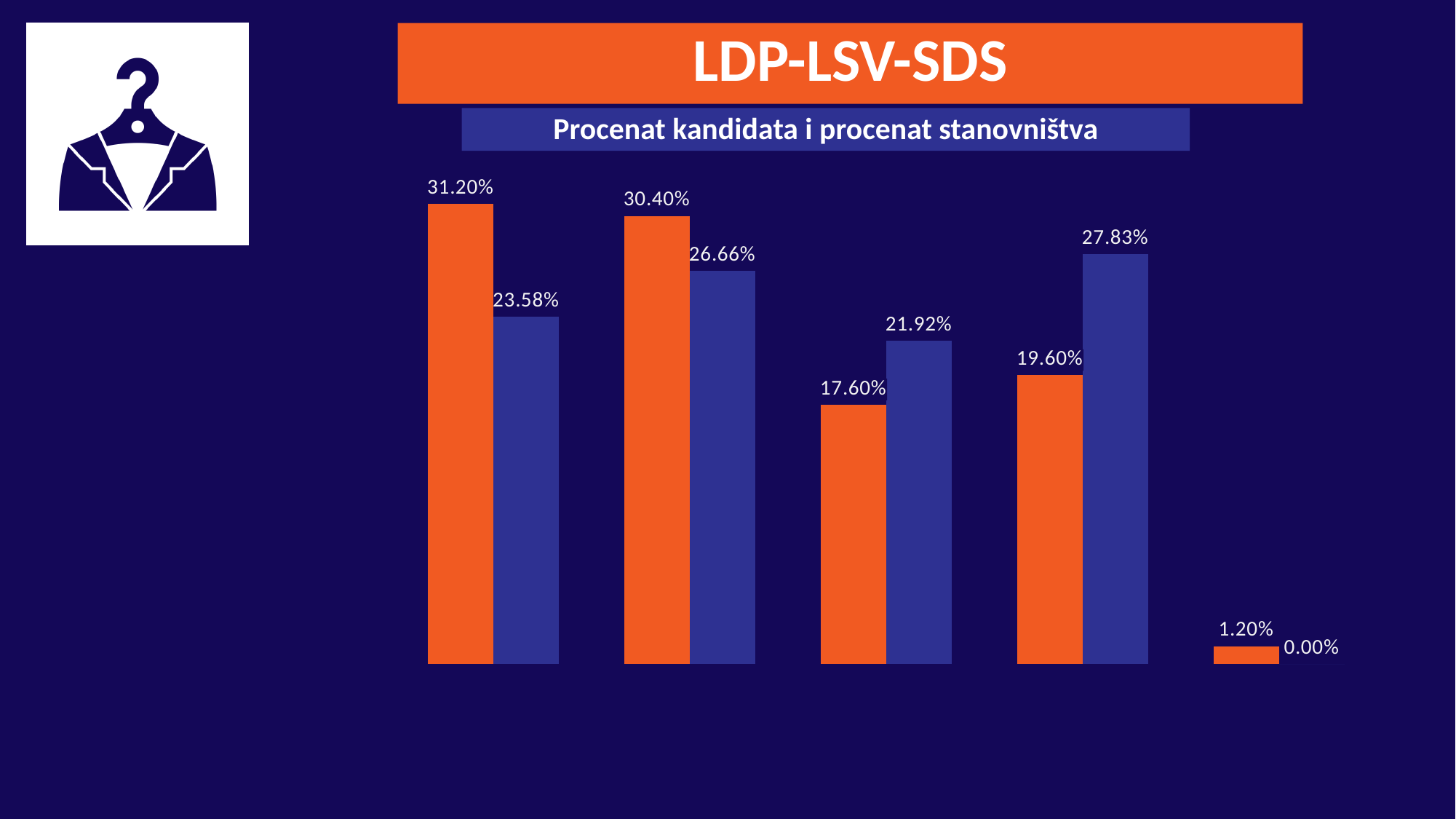
What is the value of the blue bar in the first group from the left? 23.58% What kind of chart is shown on the slide? bar chart What is the lowest value shown among the blue bars? 0.00% Which orange bar has the highest value? 31.20% In the third group from the left, which bar is larger, the orange or the blue? blue What is the subtitle shown in the blue banner above the chart? Procenat kandidata i procenat stanovništva What is the title shown in the orange banner above the chart? LDP-LSV-SDS What is the value of the blue bar in the fourth group from the left? 27.83% What is the value of the orange bar in the rightmost group? 1.20% What is the value of the orange bar in the first group from the left? 31.20% What is the difference between the orange and blue bars in the second group from the left? 3.74% How many groups of bars are shown in the chart? 5